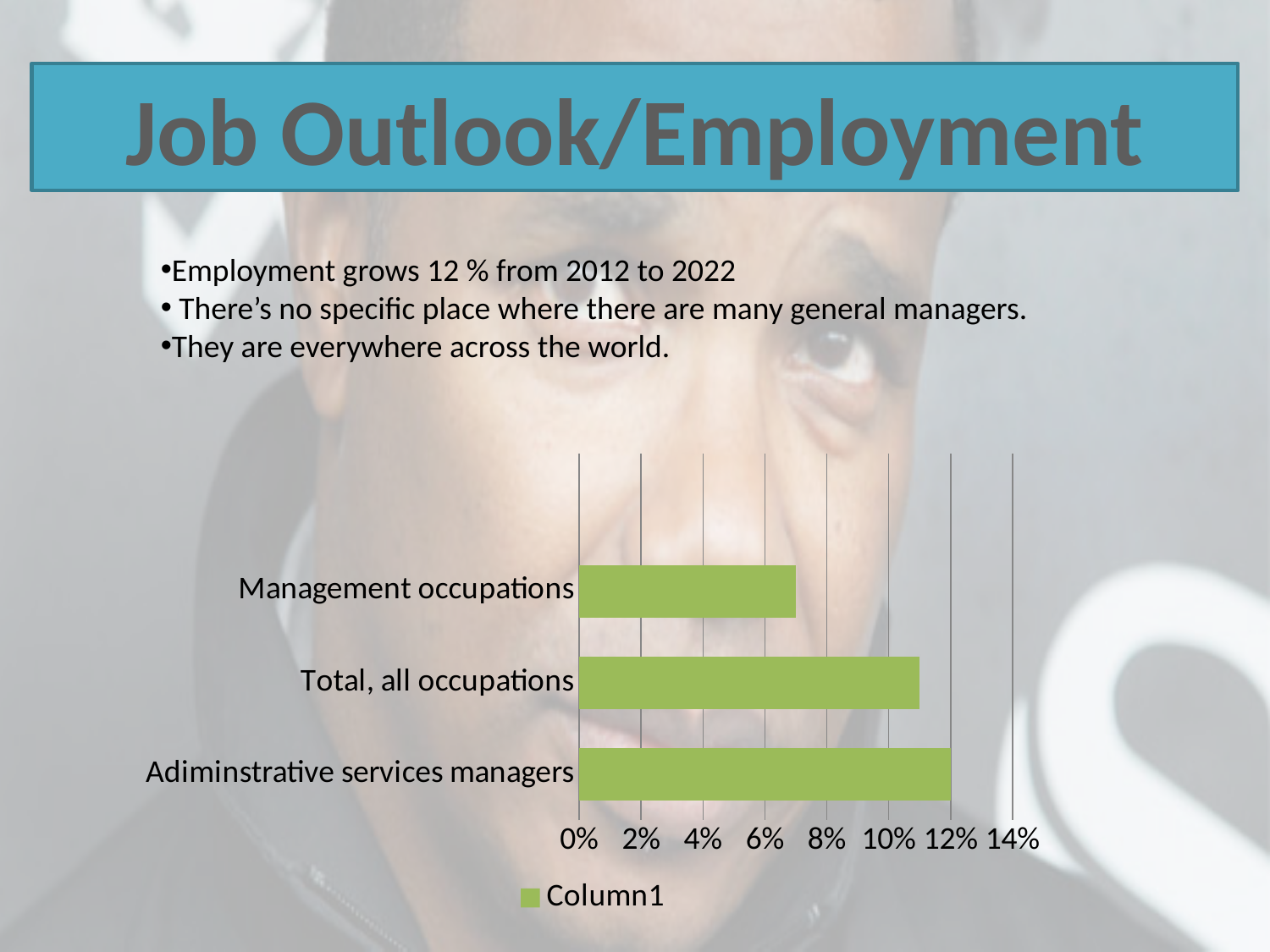
Which category has the highest value in the chart? Adiminstrative services managers How many categories are plotted in the chart? 3 What kind of chart is shown on the slide? bar chart What is the name of the series shown in the chart legend? Column1 Which is larger, the value for Total, all occupations or the value for Management occupations? Total, all occupations Is the value for Management occupations greater or less than 6%? greater How many series does the chart legend list? 1 Is the value for Total, all occupations greater or less than 10%? greater What colour are the bars in the chart? green What is the value for Adiminstrative services managers? 12% Which category has the lowest value in the chart? Management occupations Is the value for Management occupations greater or less than 8%? less